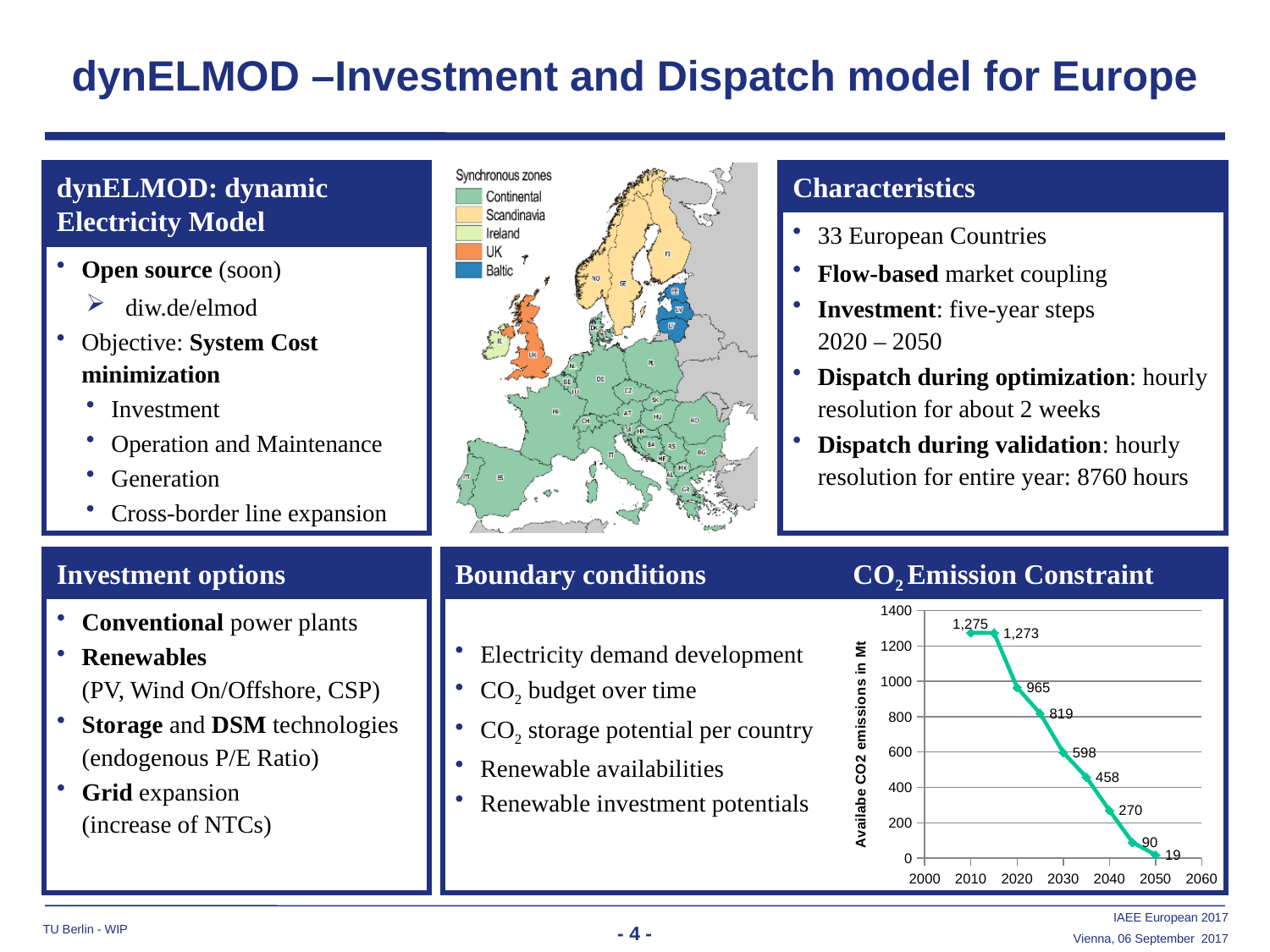
In the CO2 Emission Constraint chart, what is the value labelled at 2030? 598 In the CO2 Emission Constraint chart, what is the difference between the values labelled 965 and 819? 146 In the CO2 Emission Constraint chart, what is the difference between the values labelled 598 and 458? 140 In the CO2 Emission Constraint chart, which labelled point has the highest value? 1,275 In the CO2 Emission Constraint chart, do the values rise or fall along the x axis from 2010 to 2050? fall What is the y-axis label of the CO2 Emission Constraint chart? Availabe CO2 emissions in Mt In the CO2 Emission Constraint chart, what is the value labelled at 2050? 19 How many labelled data points are plotted in the CO2 Emission Constraint chart? 9 What type of chart is the CO2 Emission Constraint chart? line chart In the CO2 Emission Constraint chart, what is the value labelled at 2040? 270 In the CO2 Emission Constraint chart, which labelled point has the lowest value? 19 In the CO2 Emission Constraint chart, what is the available CO2 emissions value labelled at 2020? 965